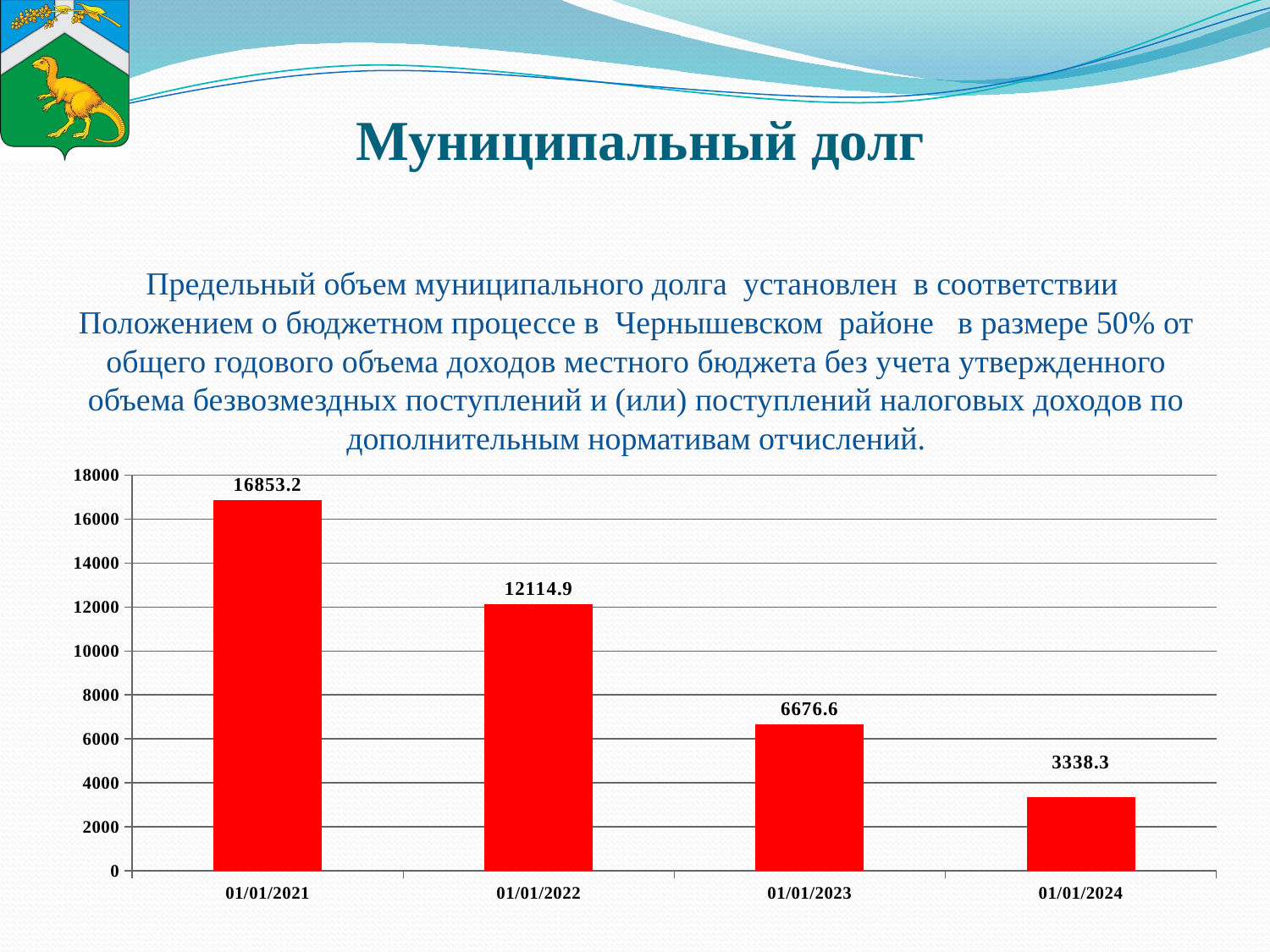
Do the values rise or fall from 01/01/2021 to 01/01/2024? Fall What is the difference between the values for 01/01/2023 and 01/01/2024? 3338.3 What is the difference between the values for 01/01/2021 and 01/01/2022? 4738.3 Which date has the lowest value? 01/01/2024 How many bars are shown in the chart? 4 Which date has the highest value? 01/01/2021 What is the value shown for 01/01/2024? 3338.3 What is the value shown for 01/01/2023? 6676.6 What kind of chart is shown on the slide? Bar chart Which is larger, the value for 01/01/2022 or the value for 01/01/2023? 01/01/2022 What is the value shown for 01/01/2021? 16853.2 What is the value shown for 01/01/2022? 12114.9